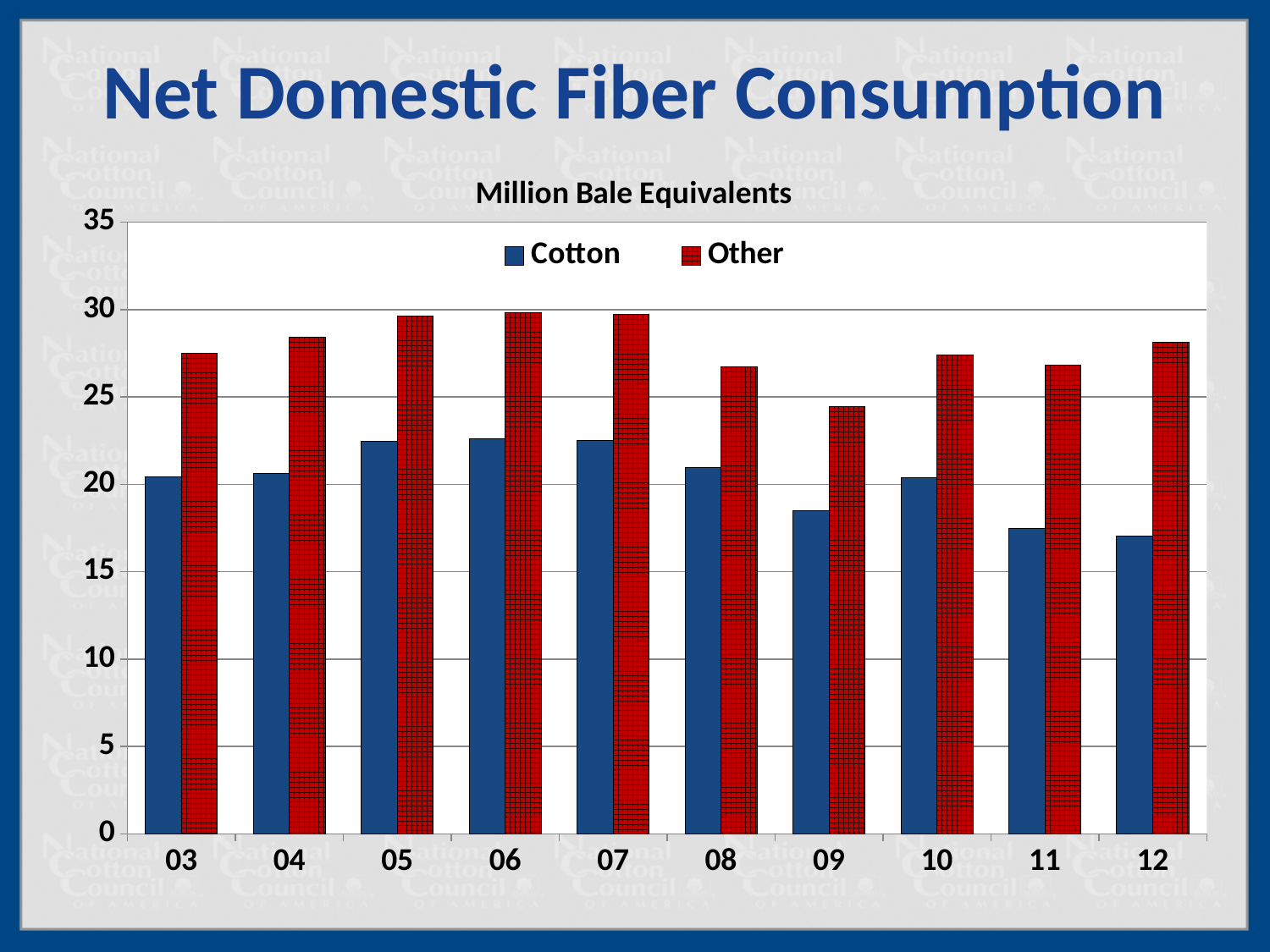
What unit is given in the chart's subtitle? Million Bale Equivalents What kind of chart is shown on the slide? bar chart Is the value for Other in 09 greater or less than 25? less Is the value for Cotton in 12 greater or less than 15? greater In 03, which is larger, Cotton or Other? Other How many years are shown on the x axis? 10 Which year has the lowest value for Other? 09 Which is larger, Cotton in 03 or Cotton in 09? Cotton in 03 How many series does the legend list? 2 Is the value for Cotton in 09 greater or less than 20? less